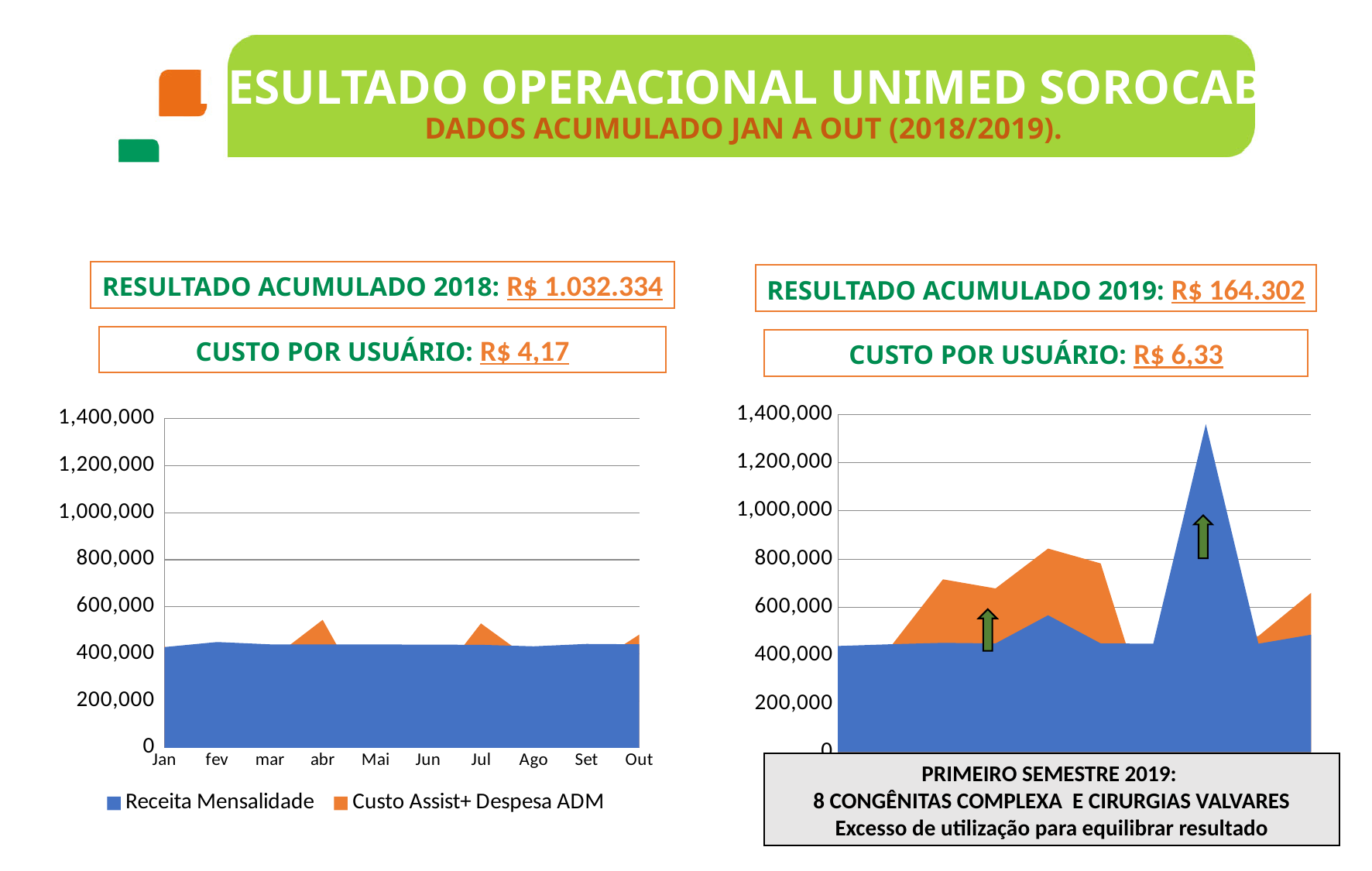
In the left chart (2018), is the value for Custo Assist+ Despesa ADM in Jul greater or less than 800,000? less In the left chart (2018), which series is shown in blue? Receita Mensalidade What kind of chart is the left chart (2018)? area chart In the right chart (2019), is the highest point of the blue series greater or less than 1,200,000? greater In the left chart (2018), which series is shown in orange? Custo Assist+ Despesa ADM In the left chart (2018), is the value for Custo Assist+ Despesa ADM in abr greater or less than 400,000? greater What is the maximum value shown on the y axis of the right chart (2019)? 1,400,000 How many series does the legend of the left chart (2018) list? 2 How many months are shown on the x axis of the left chart (2018)? 10